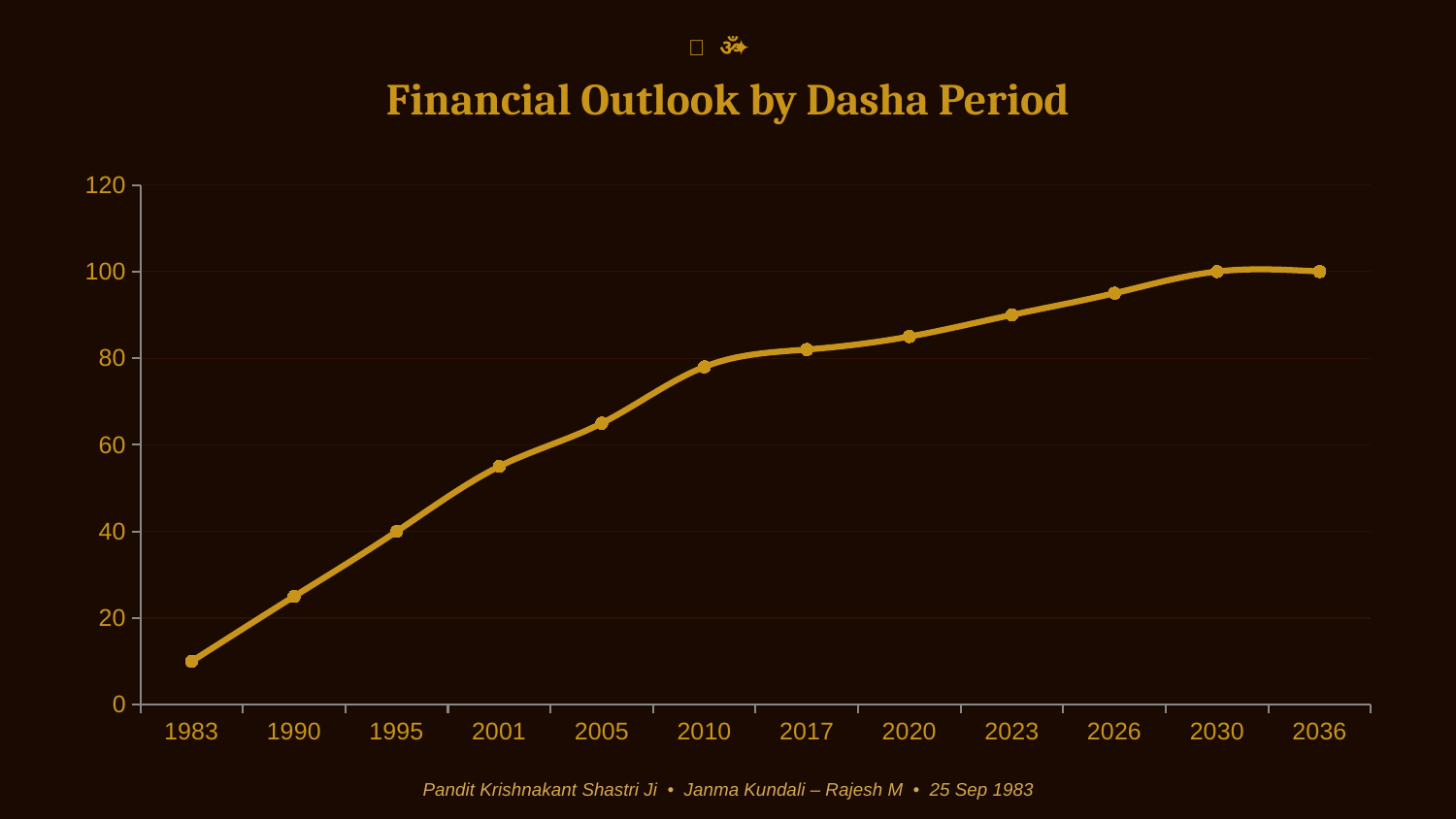
Is the value for 2005 greater or less than 60? greater What is the value for 2030? 100 Do the values generally rise or fall from 1983 to 2036? rise What is the value for 1995? 40 Is the value for 1983 greater or less than 20? less How many data points are plotted on the line? 12 What is the title of the chart? Financial Outlook by Dasha Period Which year has the lowest value? 1983 Which is larger, the value for 2001 or the value for 2010? 2010 What kind of chart is shown on the slide? line chart Is the value for 2023 greater or less than 100? less